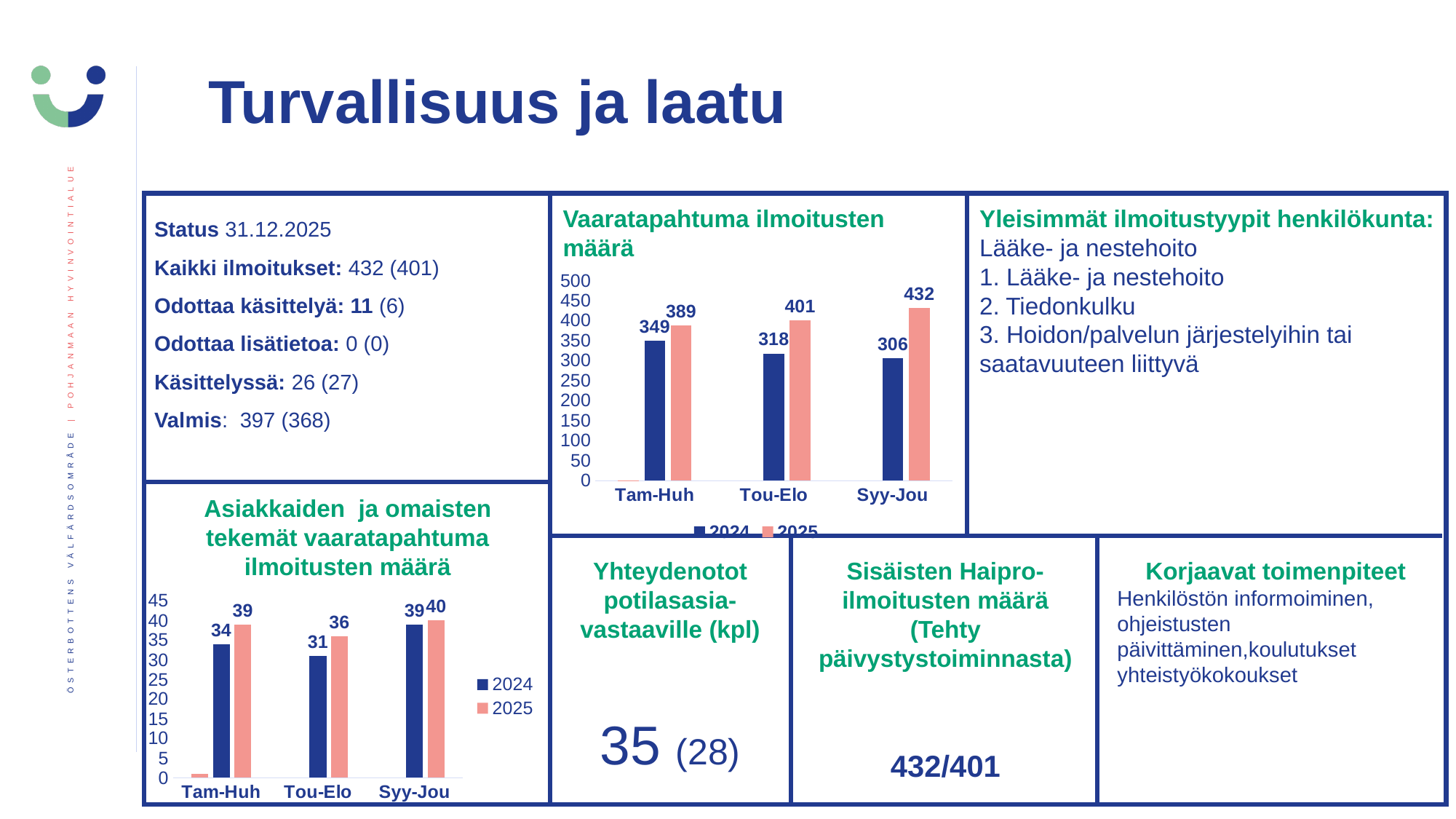
In the chart titled "Asiakkaiden ja omaisten tekemät vaaratapahtuma ilmoitusten määrä", which is larger in Tam-Huh: the 2024 value or the 2025 value? 2025 In the chart titled "Vaaratapahtuma ilmoitusten määrä", what is the difference between the 2025 and 2024 values in Syy-Jou? 126 In the chart titled "Vaaratapahtuma ilmoitusten määrä", what is the value for 2024 in Tou-Elo? 318 In the chart titled "Vaaratapahtuma ilmoitusten määrä", how many series does the legend list? 2 In the chart titled "Vaaratapahtuma ilmoitusten määrä", which period has the lowest 2024 value? Syy-Jou In the chart titled "Vaaratapahtuma ilmoitusten määrä", do the 2025 values rise or fall from Tam-Huh to Syy-Jou? rise In the chart titled "Asiakkaiden ja omaisten tekemät vaaratapahtuma ilmoitusten määrä", what is the difference between the 2025 and 2024 values in Tou-Elo? 5 In the chart titled "Asiakkaiden ja omaisten tekemät vaaratapahtuma ilmoitusten määrä", what is the value for 2024 in Tou-Elo? 31 In the chart titled "Vaaratapahtuma ilmoitusten määrä", what is the value for 2025 in Syy-Jou? 432 In the chart titled "Asiakkaiden ja omaisten tekemät vaaratapahtuma ilmoitusten määrä", how many periods are shown on the x axis? 3 What type of chart is the one titled "Asiakkaiden ja omaisten tekemät vaaratapahtuma ilmoitusten määrä"? bar chart In the chart titled "Asiakkaiden ja omaisten tekemät vaaratapahtuma ilmoitusten määrä", which period has the highest 2025 value? Syy-Jou